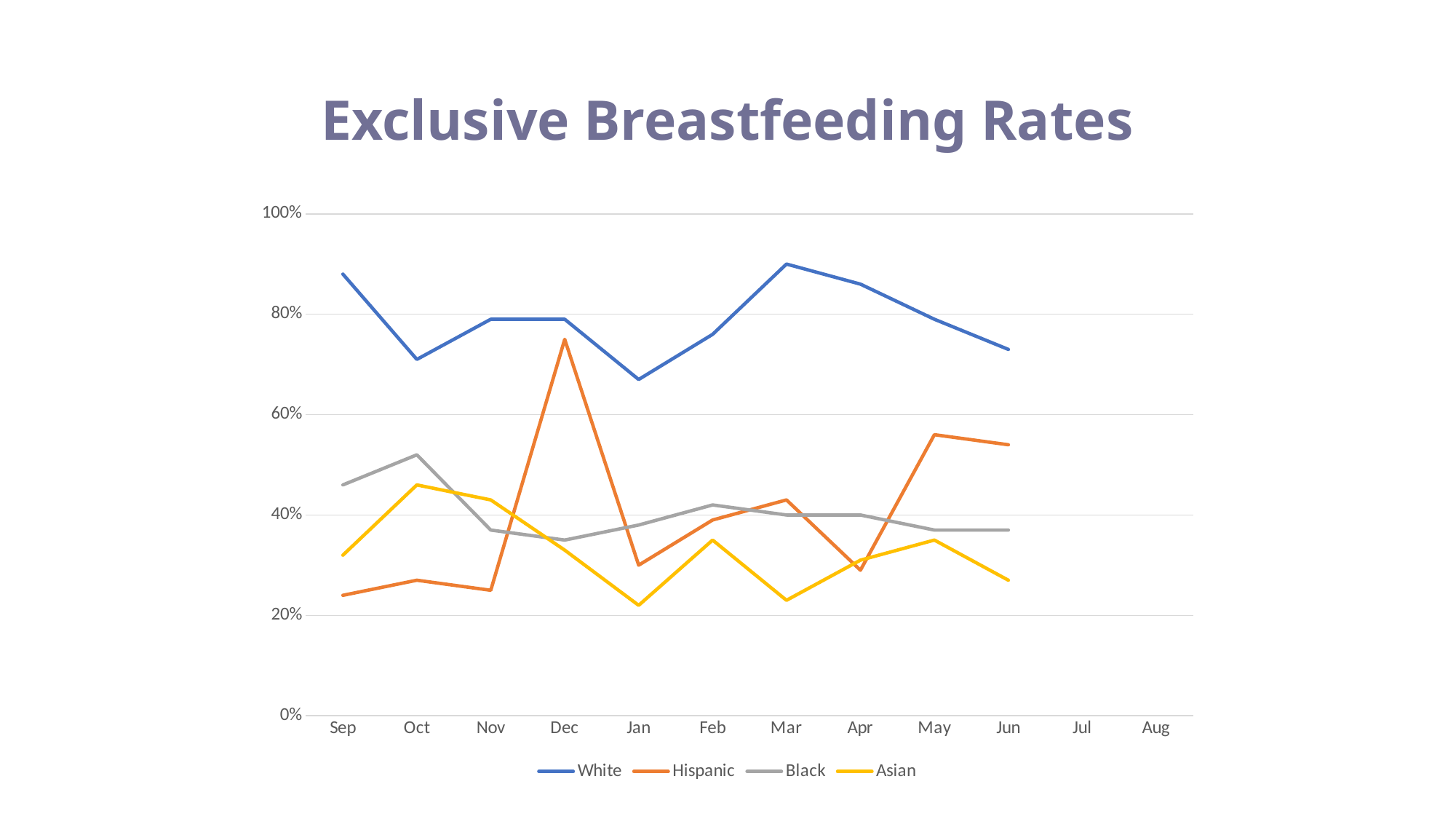
Is the value for White in Sep greater or less than 80%? greater In which month does the Black series reach its highest value? Oct Does the White series rise or fall from Mar to Jun? fall In which month does the Hispanic series reach its highest value? Dec What is the title of the chart? Exclusive Breastfeeding Rates How many series does the legend list? 4 How many month labels appear along the x axis? 12 What kind of chart is shown on the slide? line chart Which series is drawn in blue? White Is the value for White in Jan greater or less than 80%? less In May, which series has the higher value, Hispanic or Black? Hispanic Is the value for Hispanic in Sep greater or less than 40%? less